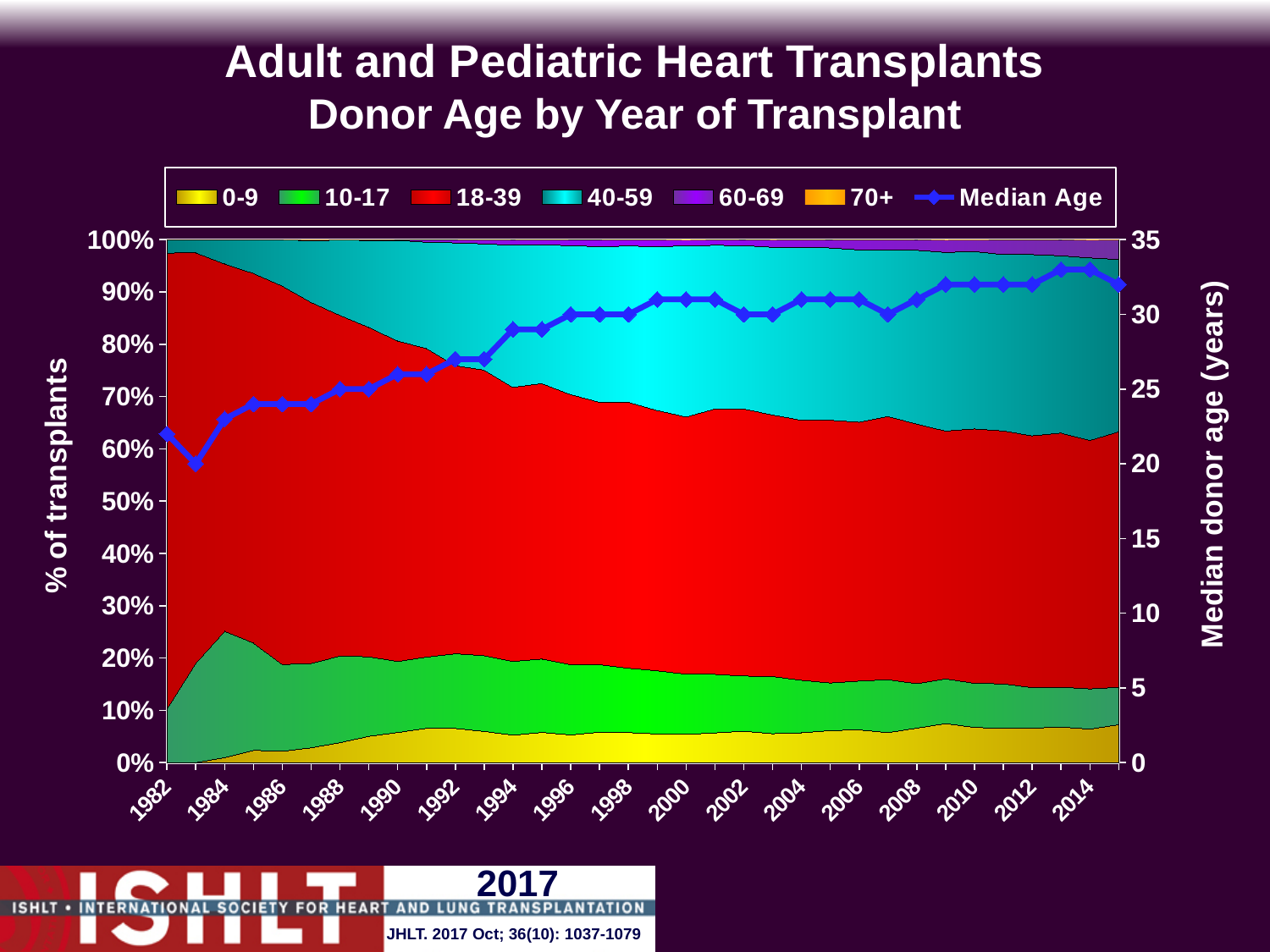
What is the title of the chart? Adult and Pediatric Heart Transplants Donor Age by Year of Transplant Is the share of transplants with donors aged 0-9 in 2014 greater or less than 10%? less Is the median donor age in 2014 greater or less than 30 years? greater Which year has the larger median donor age, 1983 or 2014? 2014 In which year is the median donor age lowest? 1983 Does the median donor age generally rise or fall from 1982 to 2015? rise What kind of chart is shown on the slide? Stacked area chart with a line for median age What is the label of the right-hand vertical axis? Median donor age (years) Does the share of transplants with donors aged 40-59 rise or fall over the years shown? rise Is the median donor age in 1982 greater or less than 25 years? less Does the share of transplants with donors aged 18-39 rise or fall over the years shown? fall How many series does the legend list? 7